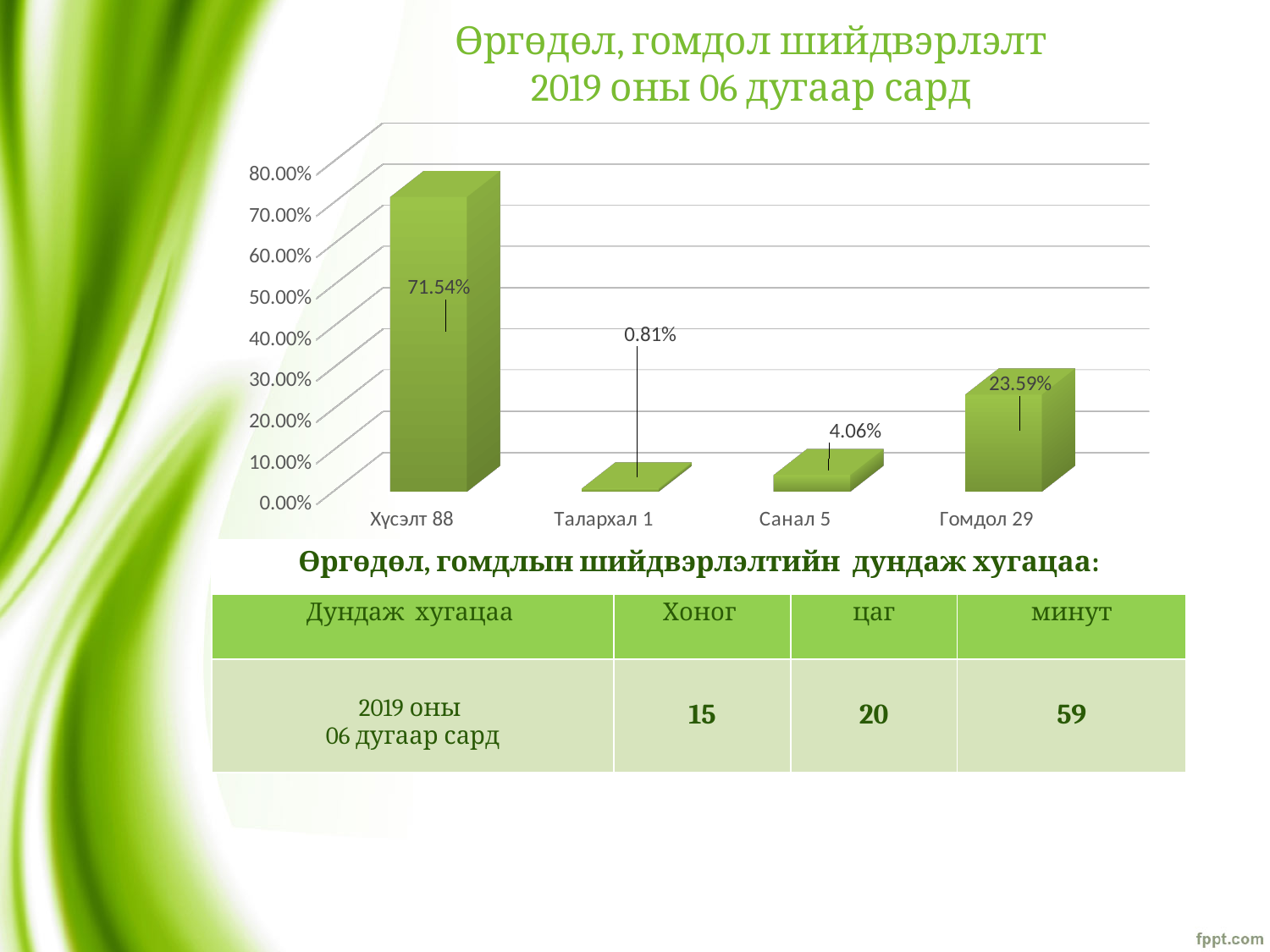
How many categories are shown on the x axis of the chart? 4 Which category has the lowest value? Талархал 1 What kind of chart is shown on the slide? bar chart Which category has the highest value? Хүсэлт 88 What is the value for Санал 5? 4.06% What is the value for Гомдол 29? 23.59% What is the value for Талархал 1? 0.81% Which is larger, the value for Санал 5 or the value for Гомдол 29? Гомдол 29 What is the difference between the values for Хүсэлт 88 and Гомдол 29? 47.95% What is the value for Хүсэлт 88? 71.54% What is the title of the chart? Өргөдөл, гомдол шийдвэрлэлт 2019 оны 06 дугаар сард Is the value for Хүсэлт 88 greater or less than 60.00%? greater